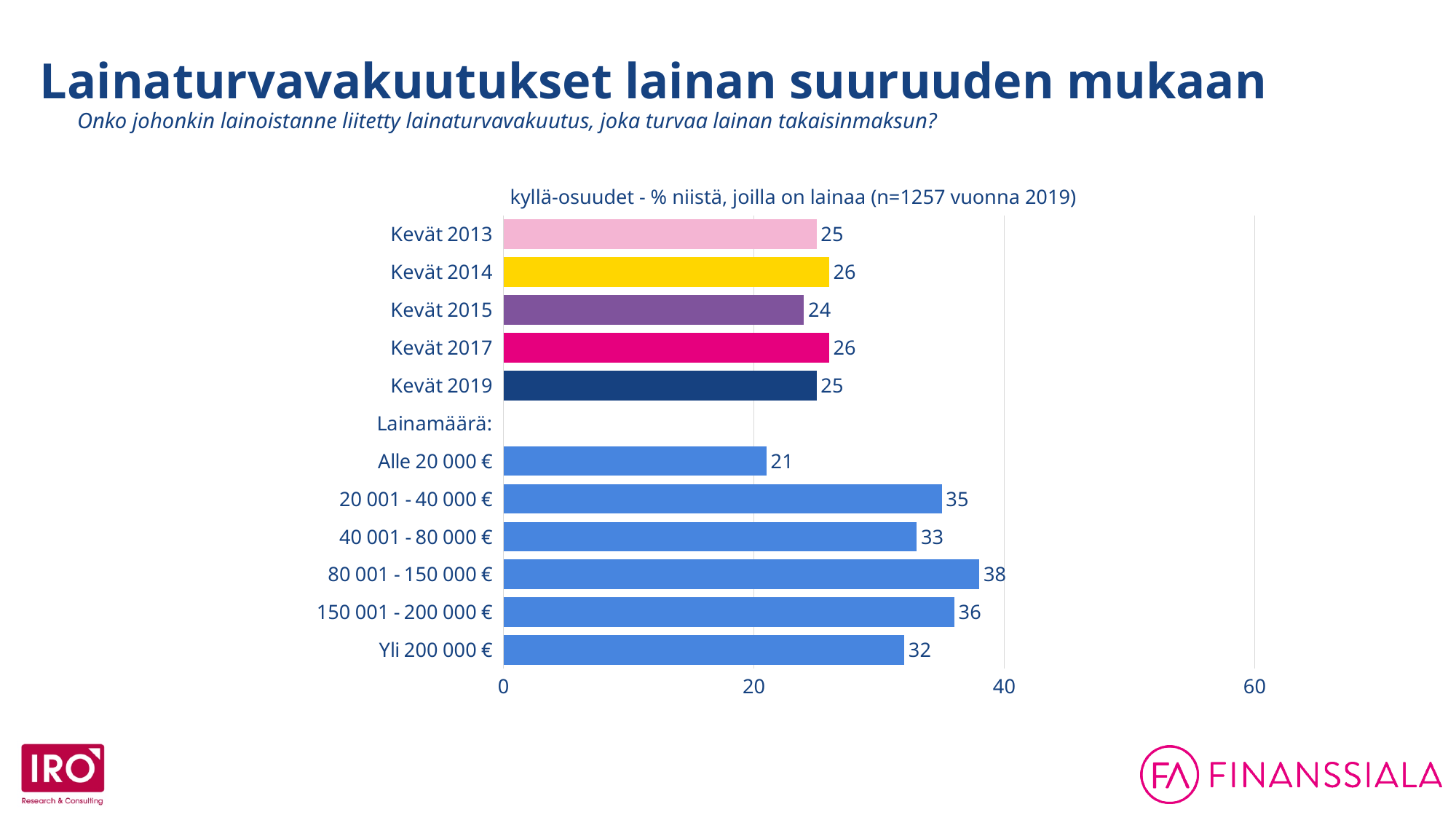
What is the value for Alle 20 000 €? 21 What is the difference between the values for 80 001 - 150 000 € and Alle 20 000 €? 17 Is the value for 150 001 - 200 000 € greater or less than 20? greater Which of the Kevät (spring) survey years has the lowest value? Kevät 2015 What kind of chart is shown on the slide? Bar chart Which is larger, the value for 20 001 - 40 000 € or the value for Yli 200 000 €? 20 001 - 40 000 € What is the value for Kevät 2019? 25 How many bars are plotted in the chart? 11 What is the difference between the values for Kevät 2014 and Kevät 2015? 2 What is the value for the loan amount category 80 001 - 150 000 €? 38 Which loan amount category has the highest value? 80 001 - 150 000 € Which loan amount category has the lowest value? Alle 20 000 €